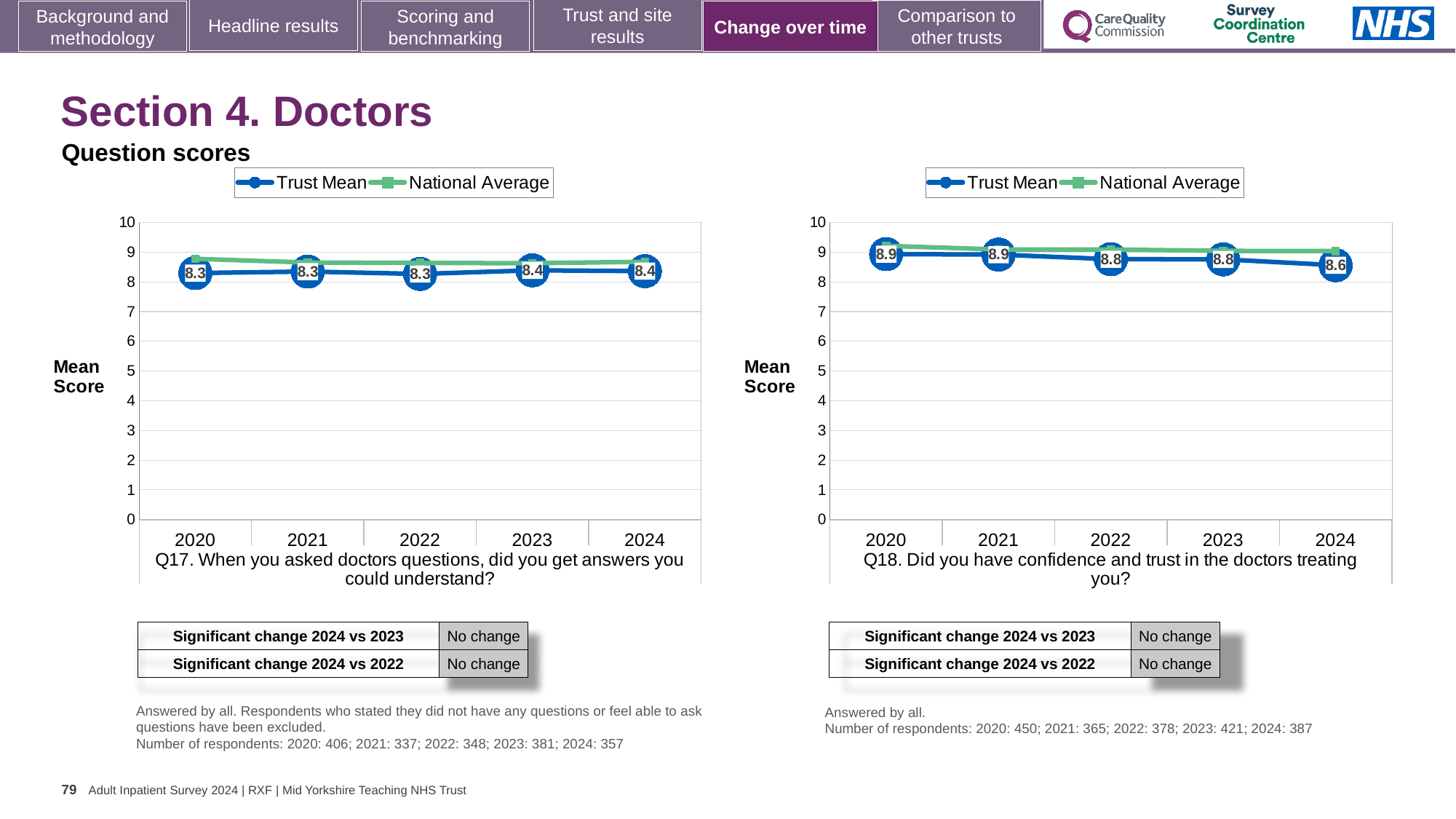
How many years are plotted on the x axis of the Q18 chart? 5 In the Q18 chart, what is the Trust Mean score for 2022? 8.8 In the Q17 chart for 2022, which series is higher: Trust Mean or National Average? National Average How many series does the legend of the Q17 chart list? 2 In the Q18 chart, which year has the lowest Trust Mean score? 2024 What type of chart is used for Q18? Line chart In the Q18 chart, what is the Trust Mean score for 2020? 8.9 In the Q17 chart, is the National Average value for 2020 greater or less than 8? greater In the Q18 chart, is the Trust Mean score higher in 2020 or in 2024? 2020 In the Q18 chart, what is the difference between the Trust Mean score in 2020 and in 2024? 0.3 In the Q17 chart, what is the Trust Mean score for 2024? 8.4 In the Q17 chart, what is the difference between the Trust Mean score in 2024 and in 2020? 0.1